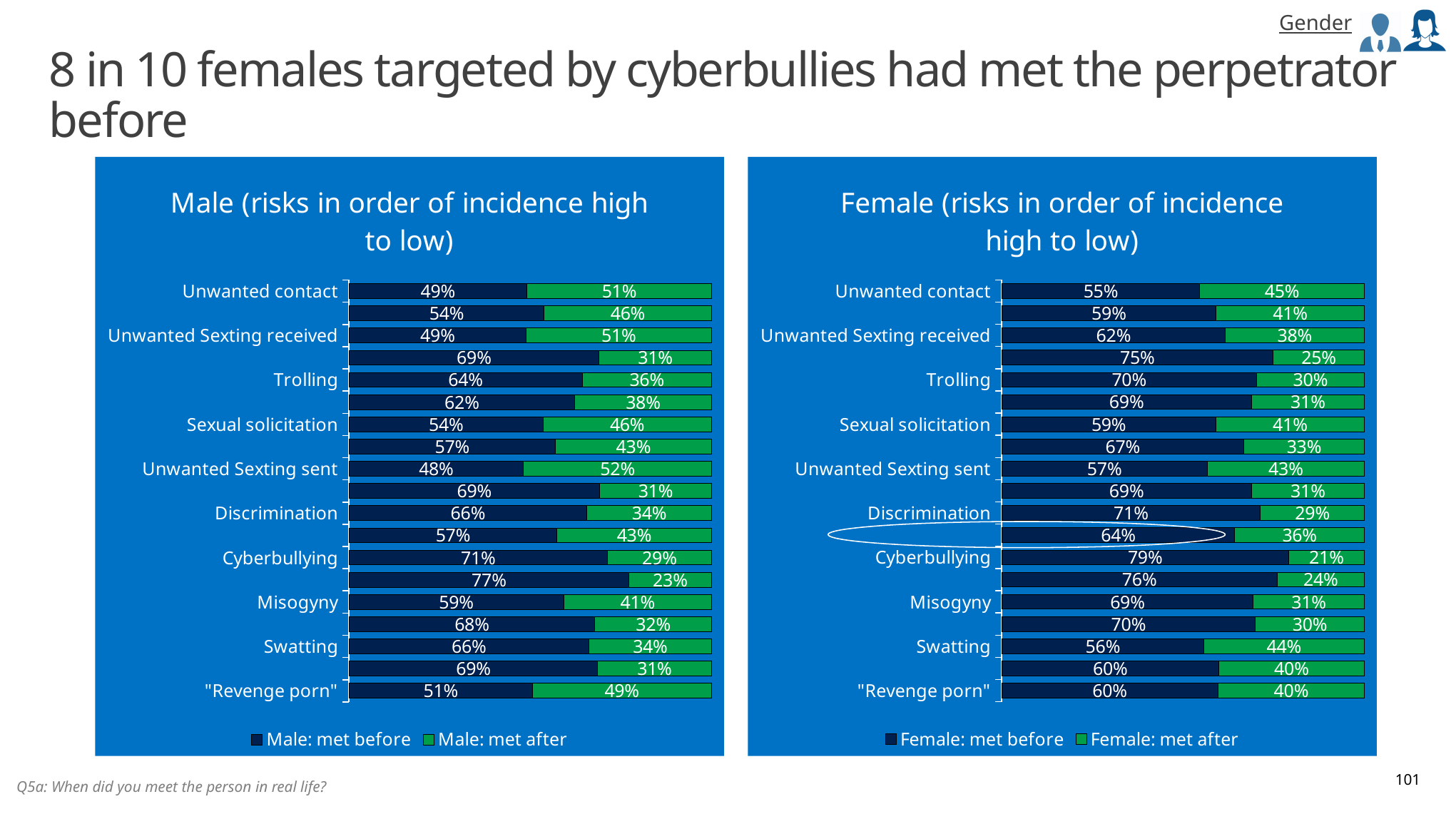
In the Male chart, what is the 'met before' value for Unwanted Sexting sent? 48% How many series does the legend of the Female chart list? 2 In the Female chart, what is the total of the stacked bar for Misogyny? 100% In the Female chart, what is the 'met after' value for Trolling? 30% In the Male chart, which is larger for Discrimination: 'met before' or 'met after'? met before In the Female chart, what is the difference between the 'met before' and 'met after' values for Cyberbullying? 58 percentage points In the Male chart, what percentage of males targeted by cyberbullying had met the perpetrator before? 71% What type of chart is the Male chart? Stacked bar chart In the Female chart, what percentage of females targeted by cyberbullying had met the perpetrator before? 79% Which is larger: the 'met before' value for Cyberbullying in the Male chart or in the Female chart? Female chart In the Male chart, what is the 'met after' value for "Revenge porn"? 49% In the Female chart, what is the 'met after' value for Swatting? 44%